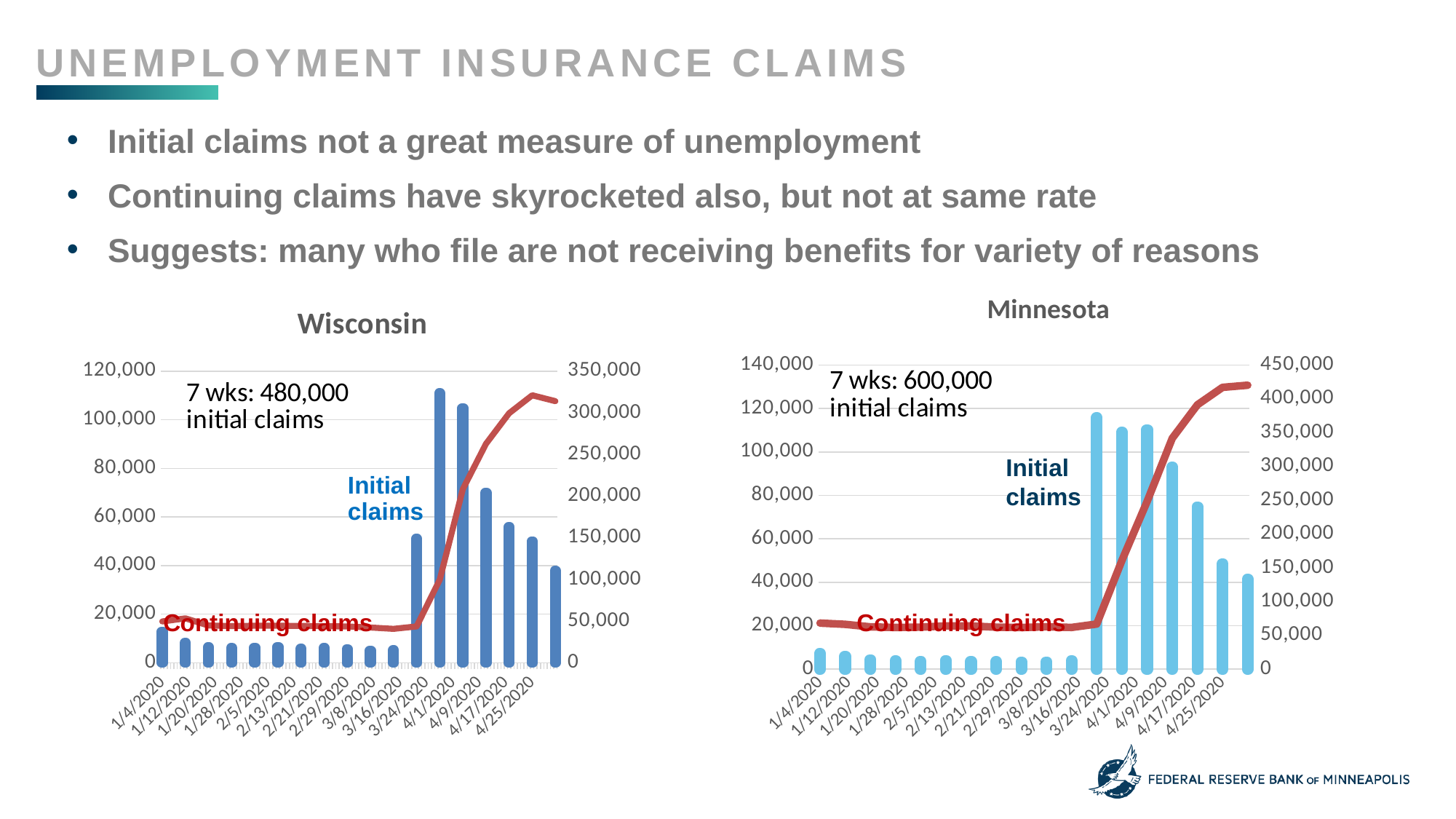
How many data series are plotted on the Minnesota chart? 2 On the Wisconsin chart, how many initial claims were filed over 7 weeks according to the annotation? 480,000 On the Wisconsin chart, is the final value of the continuing claims line greater or less than 300,000? greater On the Wisconsin chart, does the continuing claims line rise or fall from mid-March to late April? rise On the Wisconsin chart, is the tallest initial claims bar greater or less than 100,000? greater On the Minnesota chart, is the tallest initial claims bar greater or less than 100,000? greater What is the difference between the 7-week initial claims totals shown on the Minnesota and Wisconsin charts? 120,000 Which state's chart reports the larger 7-week total of initial claims, Wisconsin or Minnesota? Minnesota On the Wisconsin chart, which series is drawn as a red line? Continuing claims On the Minnesota chart, how many initial claims were filed over 7 weeks according to the annotation? 600,000